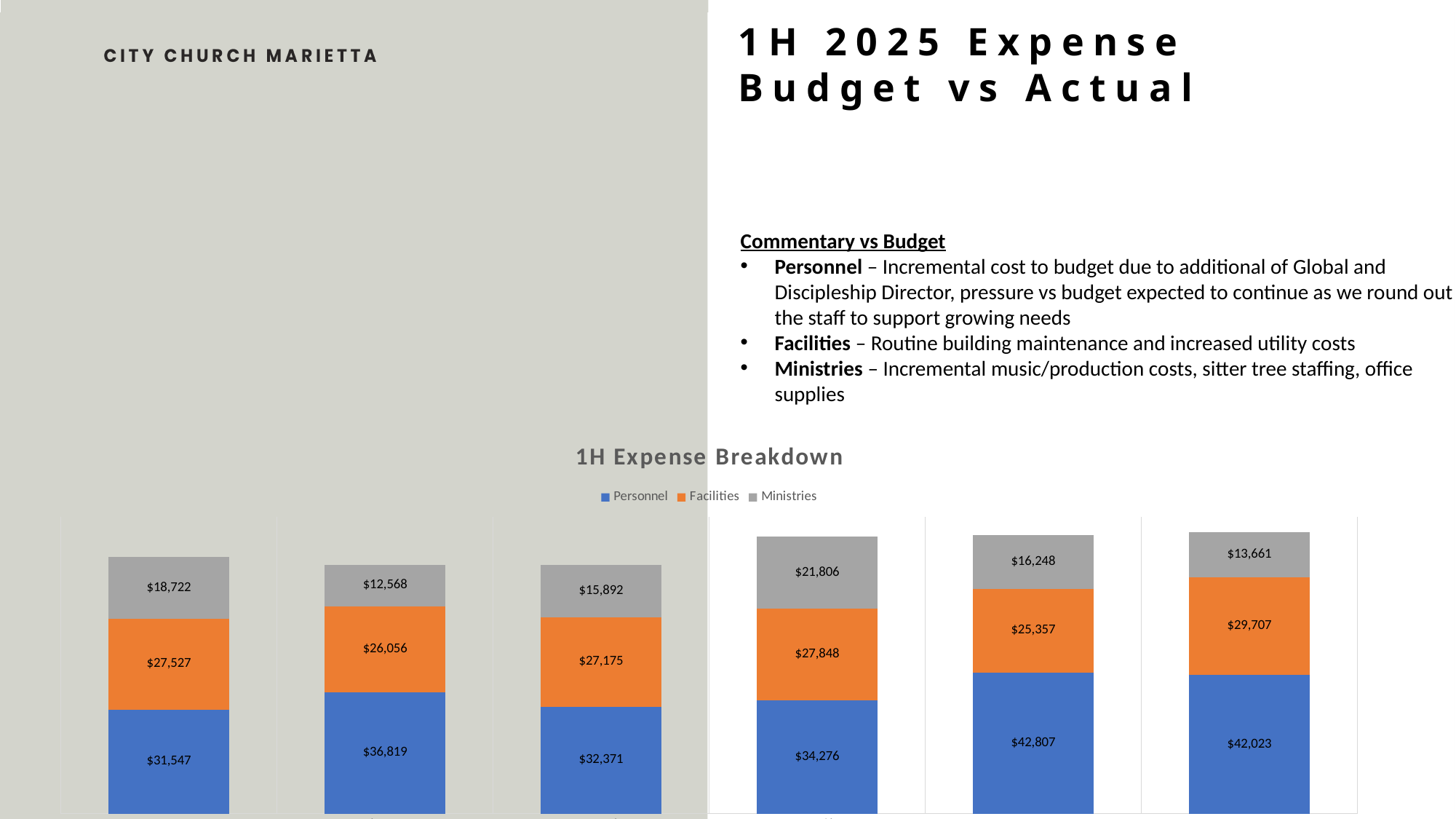
What kind of chart is the "1H Expense Breakdown" chart? Stacked bar chart In the "1H Expense Breakdown" chart, what is the Facilities value for the rightmost bar? $29,707 In the "1H Expense Breakdown" chart, what is the Ministries value for the fourth bar from the left? $21,806 In the "1H Expense Breakdown" chart, what is the difference between the Personnel values of the fifth and sixth bars from the left? $784 In the "1H Expense Breakdown" chart, is the Facilities value larger in the first bar or the second bar from the left? First bar Which series in the "1H Expense Breakdown" chart is shown in orange? Facilities In the "1H Expense Breakdown" chart, which bar (by position from the left) has the highest Personnel value? Fifth bar How many stacked bars are plotted in the "1H Expense Breakdown" chart? 6 In the "1H Expense Breakdown" chart, which bar (by position from the left) has the lowest Ministries value? Second bar In the "1H Expense Breakdown" chart, what is the Personnel value for the leftmost bar? $31,547 How many series does the legend of the "1H Expense Breakdown" chart list? 3 In the "1H Expense Breakdown" chart, what is the total of the leftmost stacked bar? $77,796